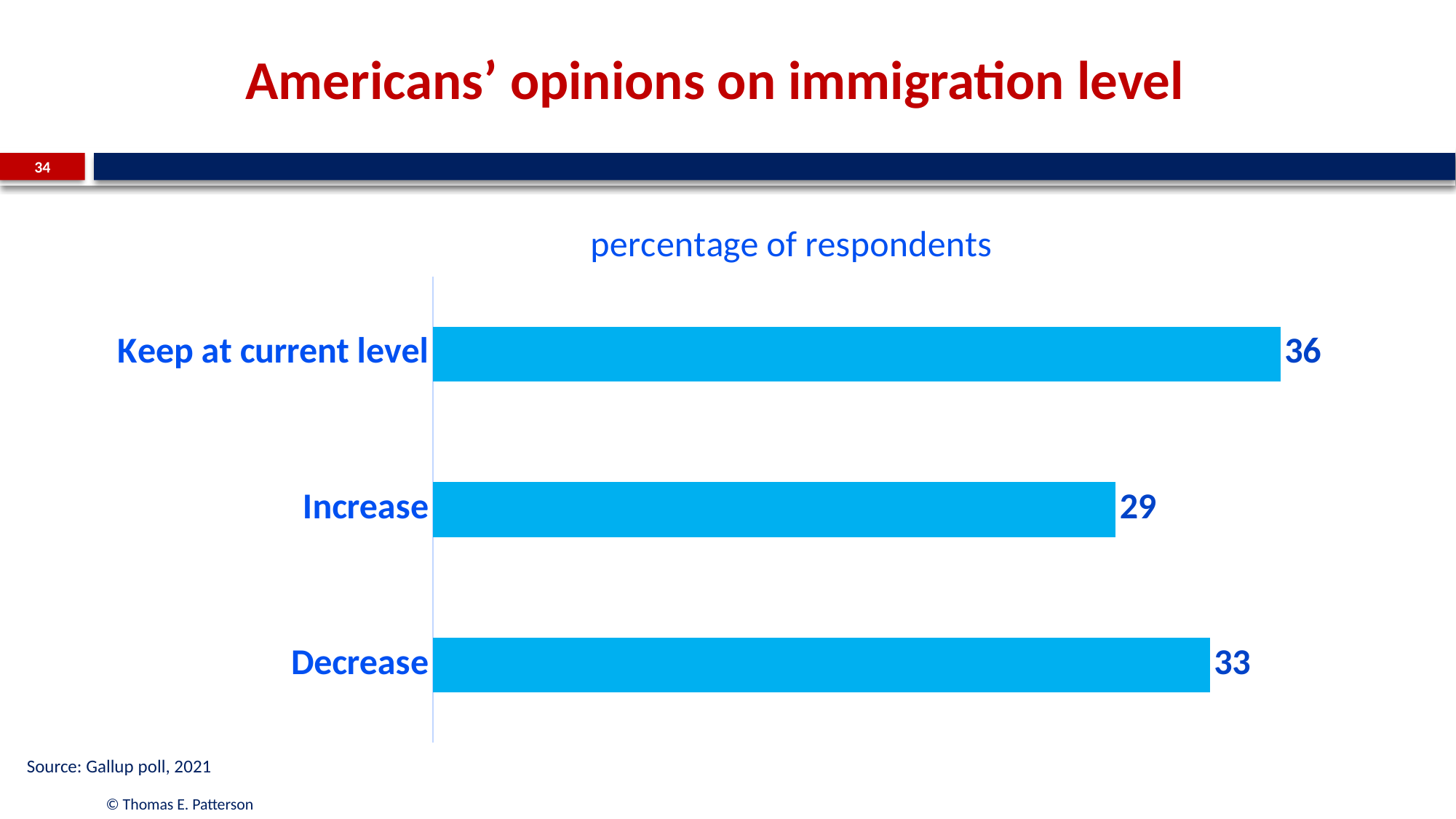
What is the difference between the values for Keep at current level and Increase? 7 What kind of chart is shown on the slide? Bar chart Which category has the highest percentage of respondents? Keep at current level What is the value for Increase? 29 What percentage of respondents want to keep immigration at the current level? 36 Which is larger, the value for Keep at current level or the value for Decrease? Keep at current level How many categories are shown in the chart? 3 What is the difference between the values for Decrease and Increase? 4 Which is larger, the value for Decrease or the value for Increase? Decrease What is the title of the chart? percentage of respondents Which category has the lowest percentage of respondents? Increase What is the value for Decrease? 33